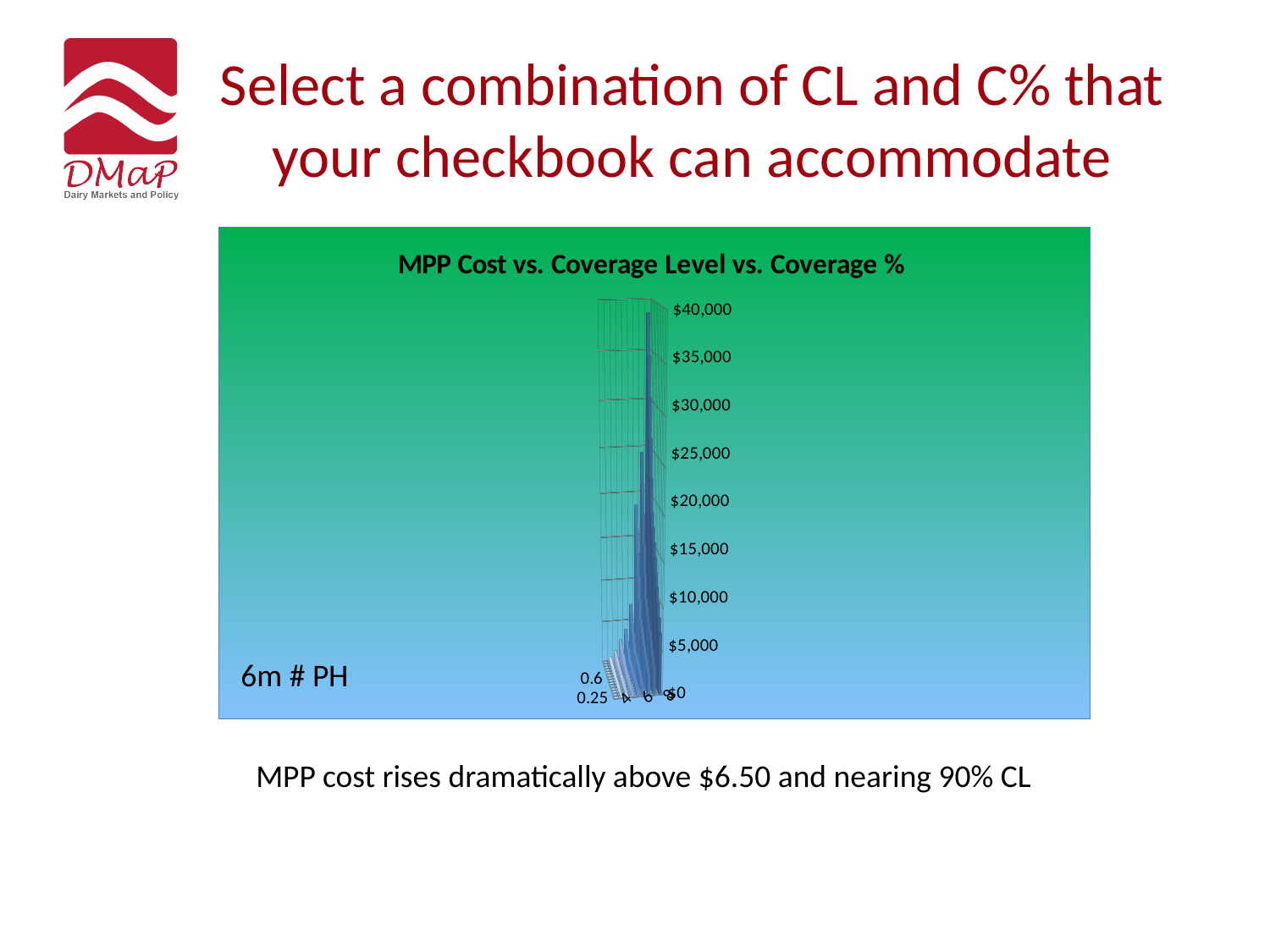
Is the tallest bar in the chart greater or less than $35,000? greater Is the tallest bar in the chart greater or less than $20,000? greater What is the highest value labelled on the chart's vertical (cost) axis? $40,000 What is the title of the chart on the slide? MPP Cost vs. Coverage Level vs. Coverage %